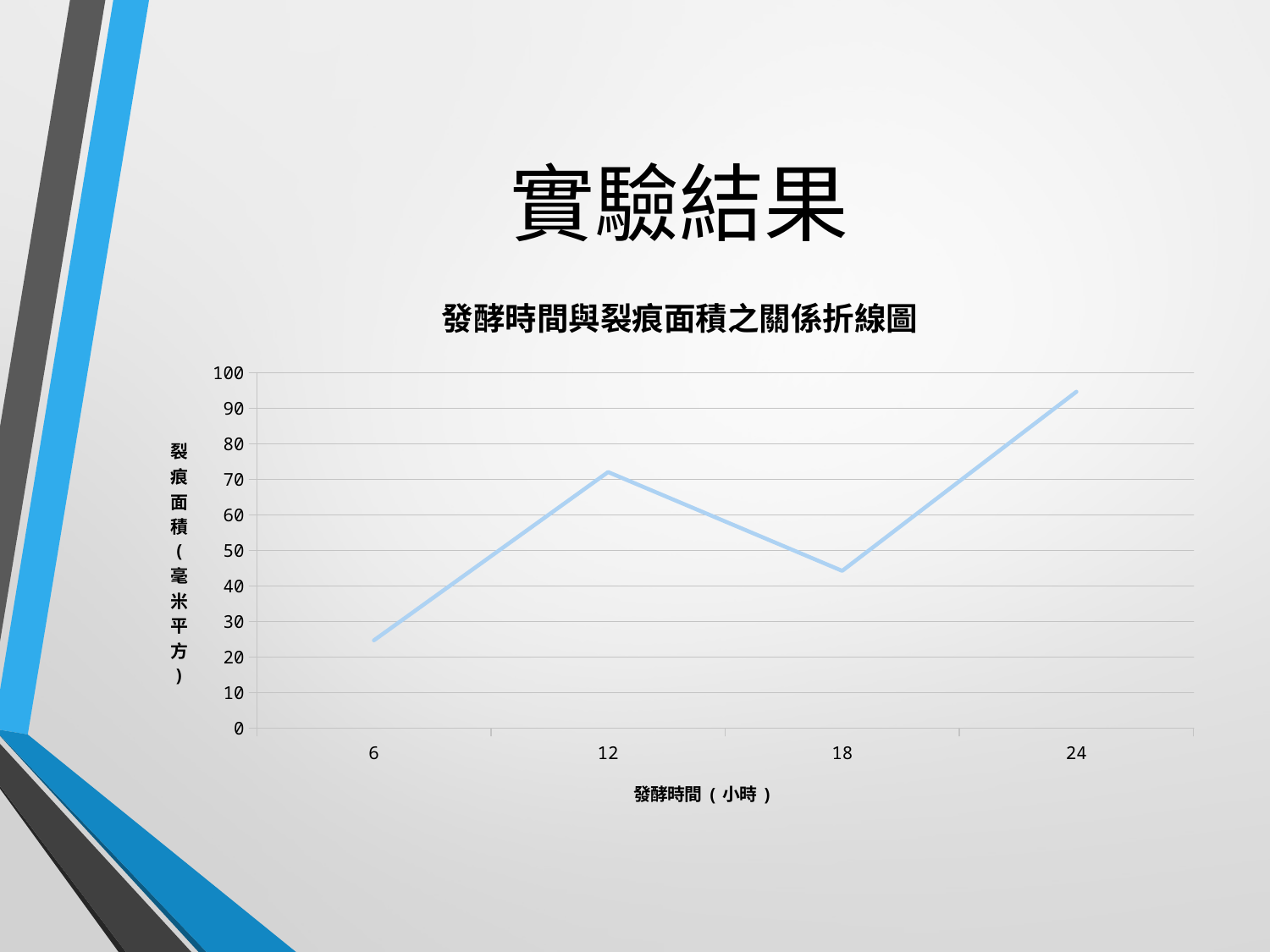
What is the label of the x axis? 發酵時間（小時） Is the crack area at 6 hours greater or less than 30? less What is the title of the chart? 發酵時間與裂痕面積之關係折線圖 How many data points are plotted on the line? 4 Is the crack area at 18 hours greater or less than 50? less At which fermentation time (發酵時間) is the crack area (裂痕面積) lowest? 6 Does the crack area rise or fall between 12 hours and 18 hours? fall Is the crack area at 24 hours greater or less than 90? greater At which fermentation time (發酵時間) is the crack area (裂痕面積) highest? 24 What kind of chart is shown on the slide? line chart Which has a larger crack area, 12 hours or 18 hours? 12 hours